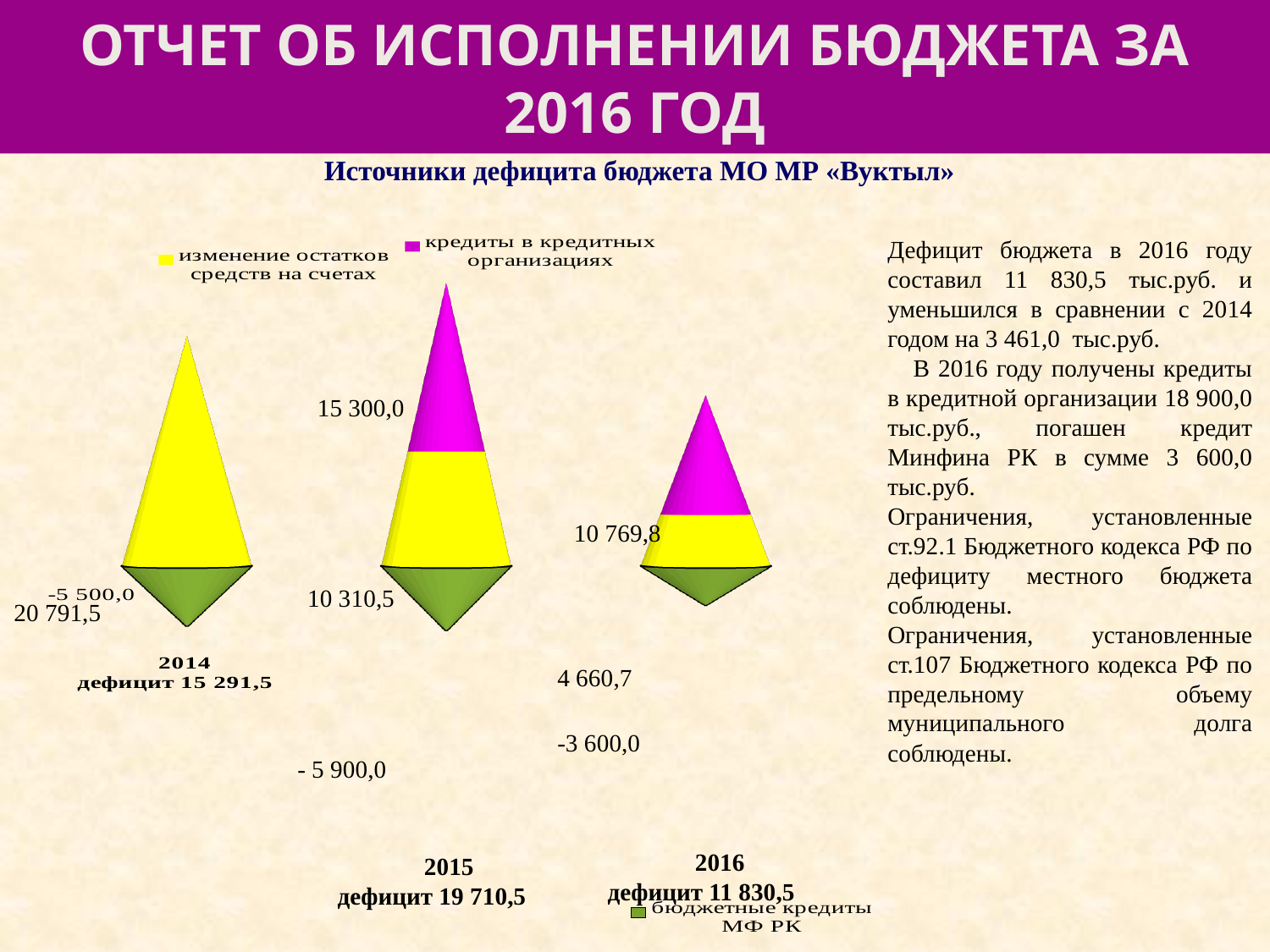
Which year has the larger value for «кредиты в кредитных организациях», 2015 or 2016? 2015 How many series does the legend list? 3 How many years are shown on the chart? 3 What is the value of «бюджетные кредиты МФ РК» for 2016? -3 600,0 What is the difference between the deficit for 2014 and the deficit for 2016? 3 461,0 Which year has the highest deficit shown on the chart? 2015 What is the difference between the «изменение остатков средств на счетах» values for 2014 and 2015? 10 481,0 What is the value of «изменение остатков средств на счетах» for 2016? 4 660,7 What deficit is shown for 2015? 19 710,5 What is the value of «изменение остатков средств на счетах» for 2014? 20 791,5 What is the value of «кредиты в кредитных организациях» for 2015? 15 300,0 What is the value of «кредиты в кредитных организациях» for 2016? 10 769,8